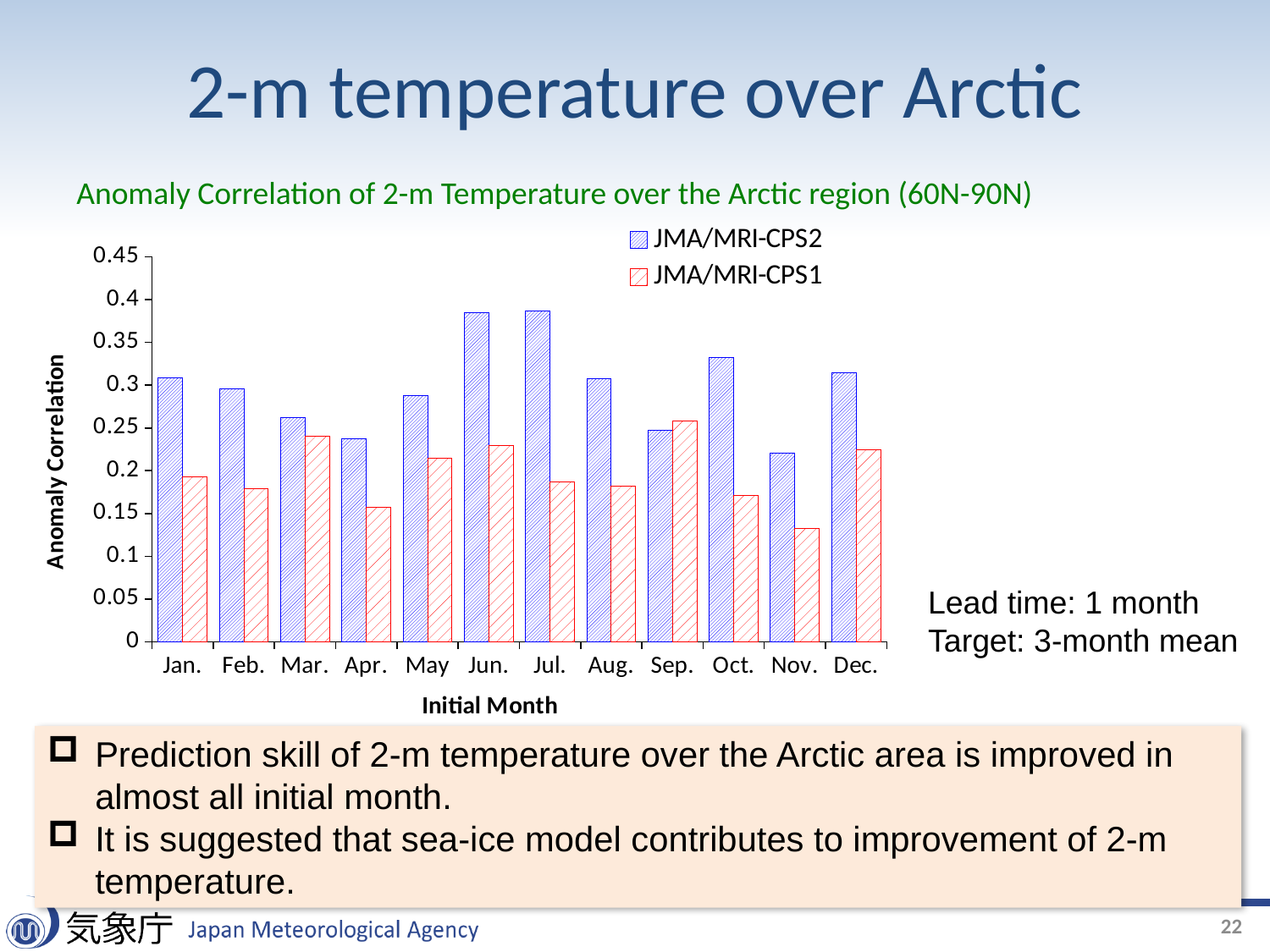
Which initial month has the lowest JMA/MRI-CPS1 anomaly correlation? Nov. Is the JMA/MRI-CPS1 value for Apr. greater or less than 0.2? less Which series is shown with blue hatched bars? JMA/MRI-CPS2 How many initial months are shown on the x axis? 12 Is the JMA/MRI-CPS2 value for Oct. greater or less than 0.3? greater Is the JMA/MRI-CPS1 value for Nov. greater or less than 0.15? less What kind of chart is shown on the slide? Bar chart For Jan., which series has the larger anomaly correlation, JMA/MRI-CPS2 or JMA/MRI-CPS1? JMA/MRI-CPS2 How many series does the legend list? 2 What is the label of the y axis? Anomaly Correlation For Nov., which series has the larger anomaly correlation, JMA/MRI-CPS2 or JMA/MRI-CPS1? JMA/MRI-CPS2